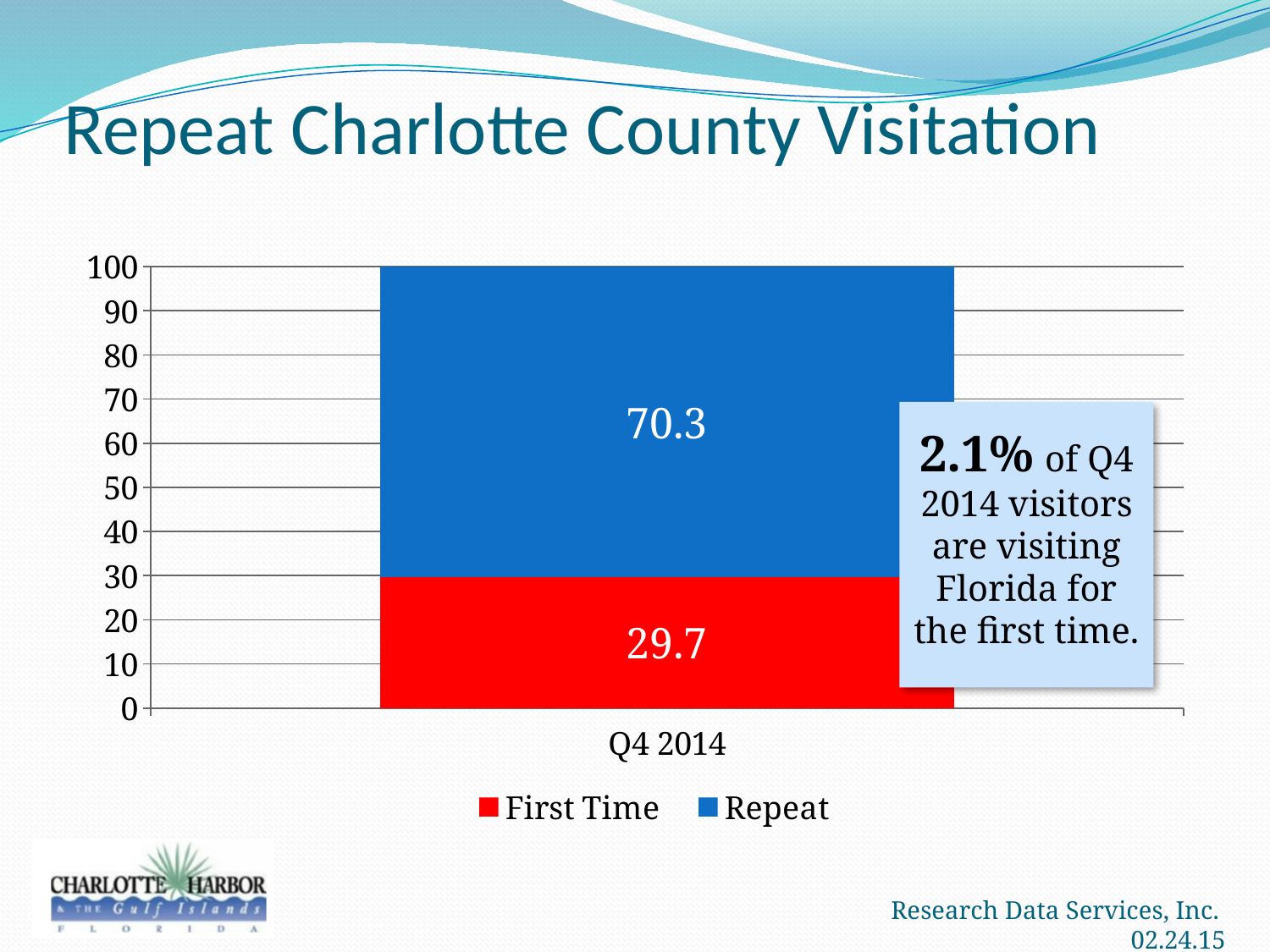
What kind of chart is shown on the slide? Stacked bar chart What is the title of the slide? Repeat Charlotte County Visitation Which colour represents the Repeat series in the legend? Blue How many categories are shown on the x axis? 1 What is the total of the stacked bar for Q4 2014? 100 Which series has the larger value in Q4 2014, First Time or Repeat? Repeat What is the value for Repeat visitors in Q4 2014? 70.3 Is the value for Repeat visitors greater or less than 70? greater How many series does the legend list? 2 What is the value for First Time visitors in Q4 2014? 29.7 What is the difference between the Repeat and First Time values for Q4 2014? 40.6 Is the value for First Time visitors greater or less than 30? less